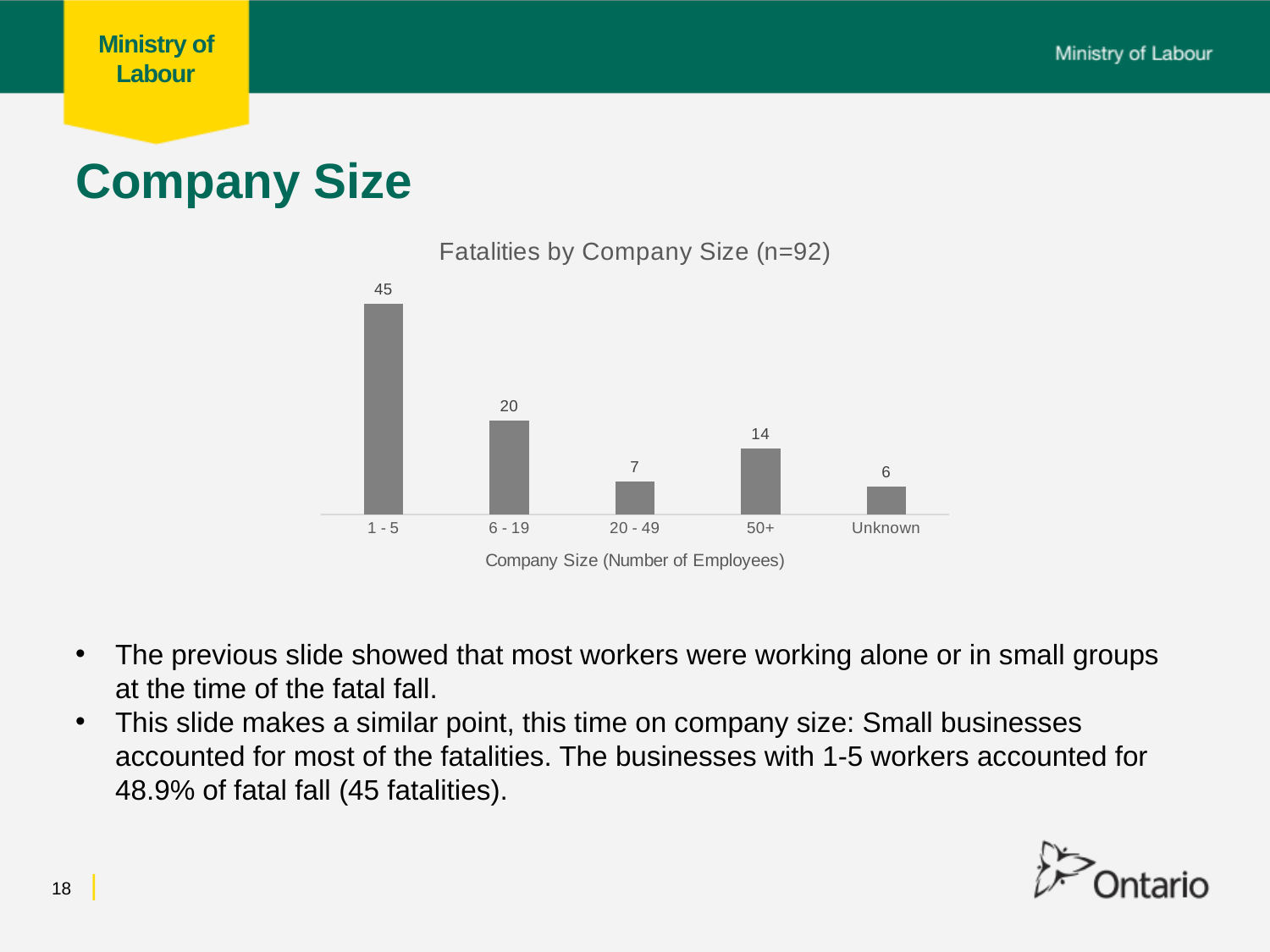
What is the number of fatalities for companies with 6 - 19 employees? 20 What is the number of fatalities for the Unknown company size category? 6 How many company size categories are shown in the chart? 5 What type of chart is used to show fatalities by company size? Bar chart What is the number of fatalities for companies with 1 - 5 employees? 45 What is the difference in fatalities between the 50+ and 20 - 49 company size categories? 7 Which has more fatalities: companies with 20 - 49 employees or companies with 50+ employees? 50+ What is the title of the chart? Fatalities by Company Size (n=92) What is the number of fatalities for companies with 50+ employees? 14 Which company size category has the lowest number of fatalities? Unknown What is the difference in fatalities between the 1 - 5 and 6 - 19 company size categories? 25 Which company size category has the highest number of fatalities? 1 - 5